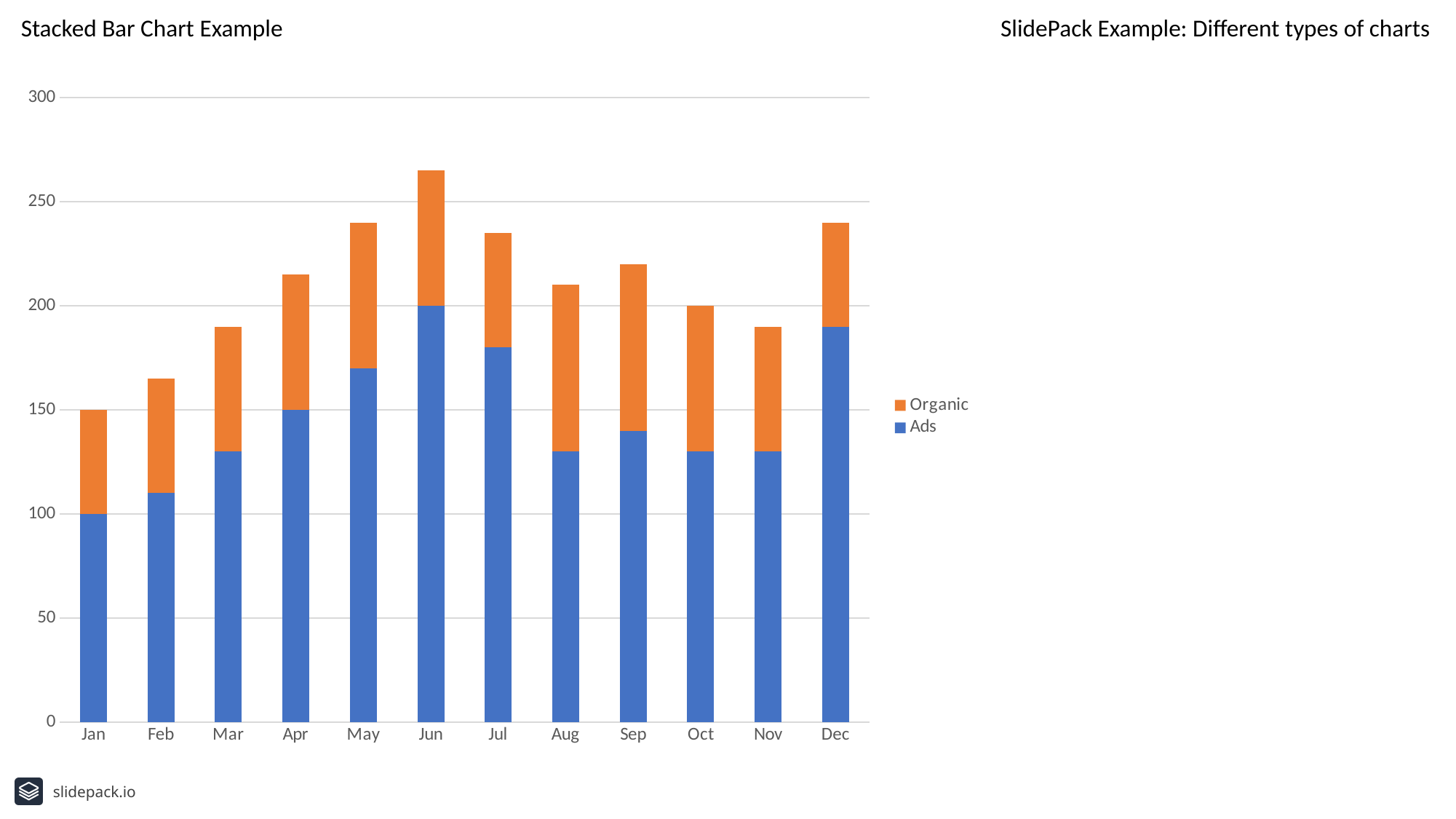
Which month has the highest total bar? Jun Which is larger, the total bar for Jun or the total bar for Jul? Jun What is the Ads value for Jan? 100 Is the Ads value for Dec greater or less than 150? greater What is the Ads value for Jun? 200 Is the total for Jun greater or less than 250? greater What type of chart is shown on the slide? Stacked bar chart Which month has the lowest total bar? Jan How many months are shown on the x axis? 12 What is the total of the stacked bar for Oct? 200 How many series does the legend list? 2 Which colour represents the Organic series in the legend? Orange